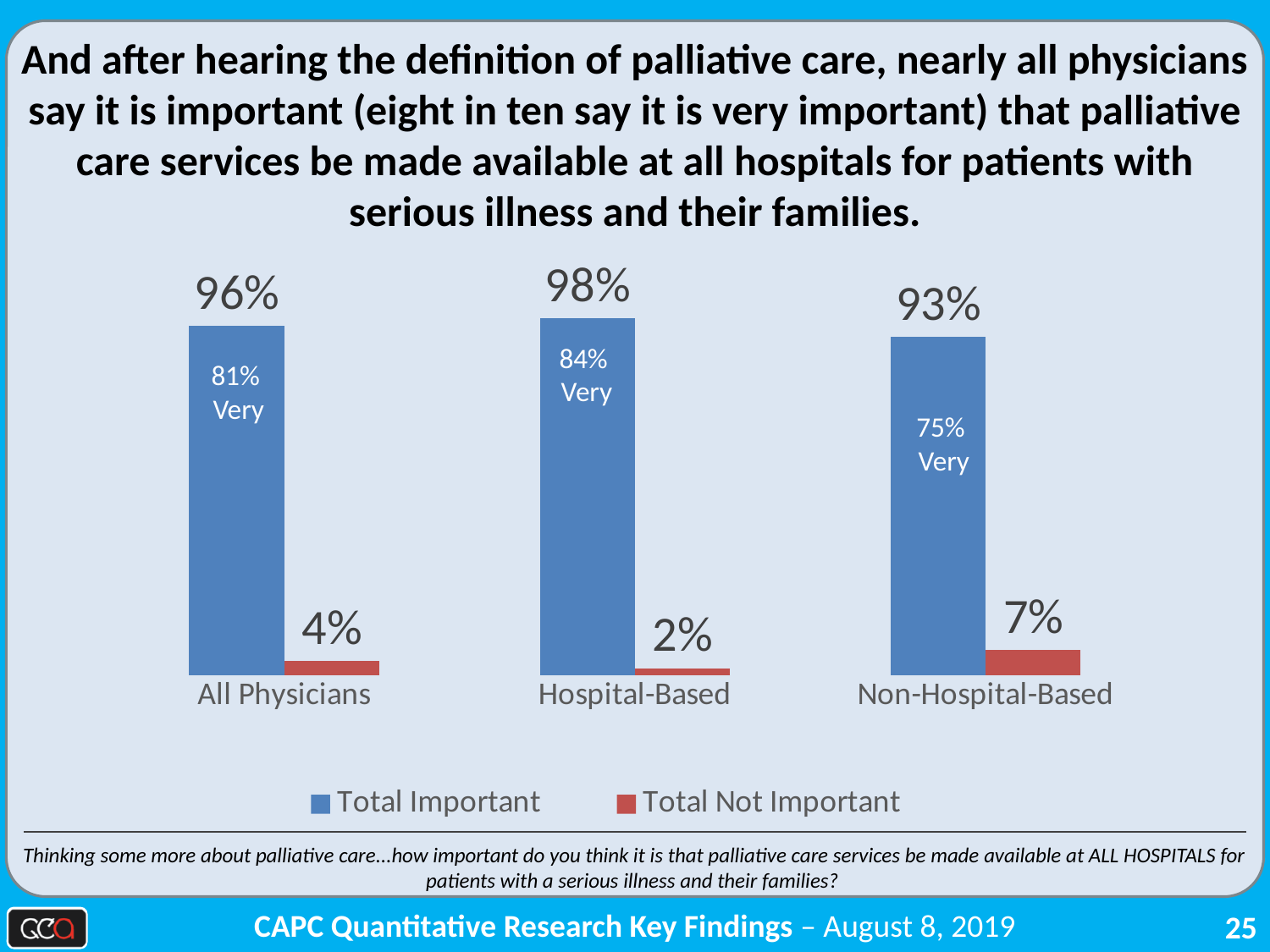
What kind of chart is shown on the slide? Bar chart How many categories are shown on the x axis? 3 What colour are the Total Not Important bars? Red What is the 'Very' important percentage for Non-Hospital-Based physicians? 75% Which is larger: the Total Not Important value for All Physicians or for Non-Hospital-Based? Non-Hospital-Based How many series does the legend list? 2 Which category has the highest Total Important value? Hospital-Based What is the Total Not Important value for Non-Hospital-Based physicians? 7% What is the Total Important value for Hospital-Based physicians? 98% What is the difference between the Total Important values for Hospital-Based and Non-Hospital-Based physicians? 5% Which category has the lowest Total Not Important value? Hospital-Based What percentage of All Physicians say palliative care availability is very important? 81%